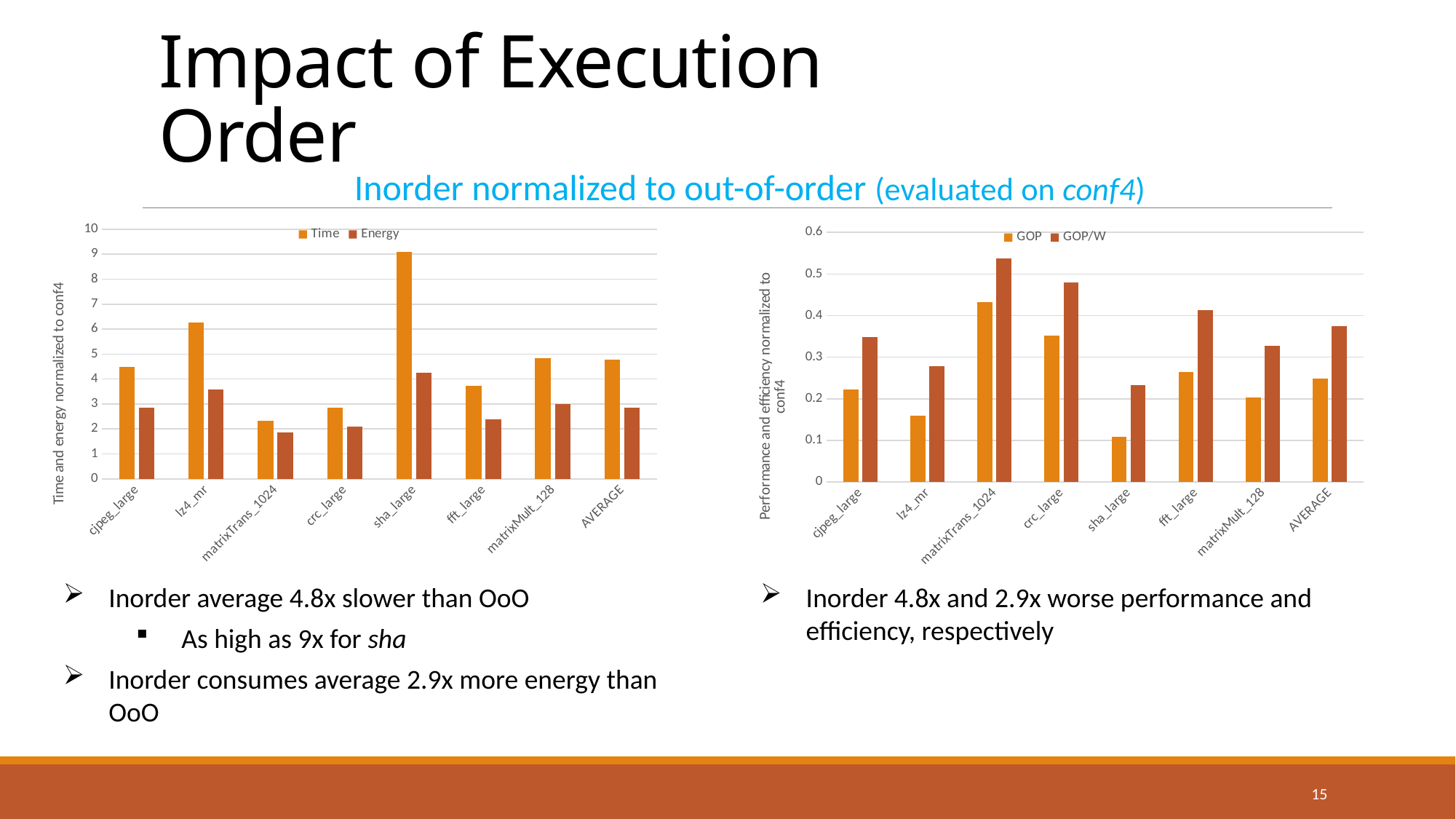
On the left chart (Time and Energy), is the Time value for sha_large greater or less than 8? greater On the left chart (Time and Energy), which category has the highest Time value? sha_large On the left chart (Time and Energy), which category has the lowest Time value? matrixTrans_1024 On the left chart (Time and Energy), for lz4_mr, which is larger: Time or Energy? Time On the left chart (Time and Energy), how many categories are shown on the x axis? 8 On the right chart (GOP and GOP/W), is the GOP/W value for matrixTrans_1024 greater or less than 0.5? greater On the left chart (Time and Energy), how many series does the legend list? 2 On the right chart (GOP and GOP/W), for crc_large, which is larger: GOP or GOP/W? GOP/W On the left chart (Time and Energy), is the Energy value for crc_large greater or less than 3? less On the right chart (GOP and GOP/W), which category has the lowest GOP value? sha_large What kind of chart is the right chart (GOP and GOP/W)? bar chart On the right chart (GOP and GOP/W), which category has the highest GOP/W value? matrixTrans_1024